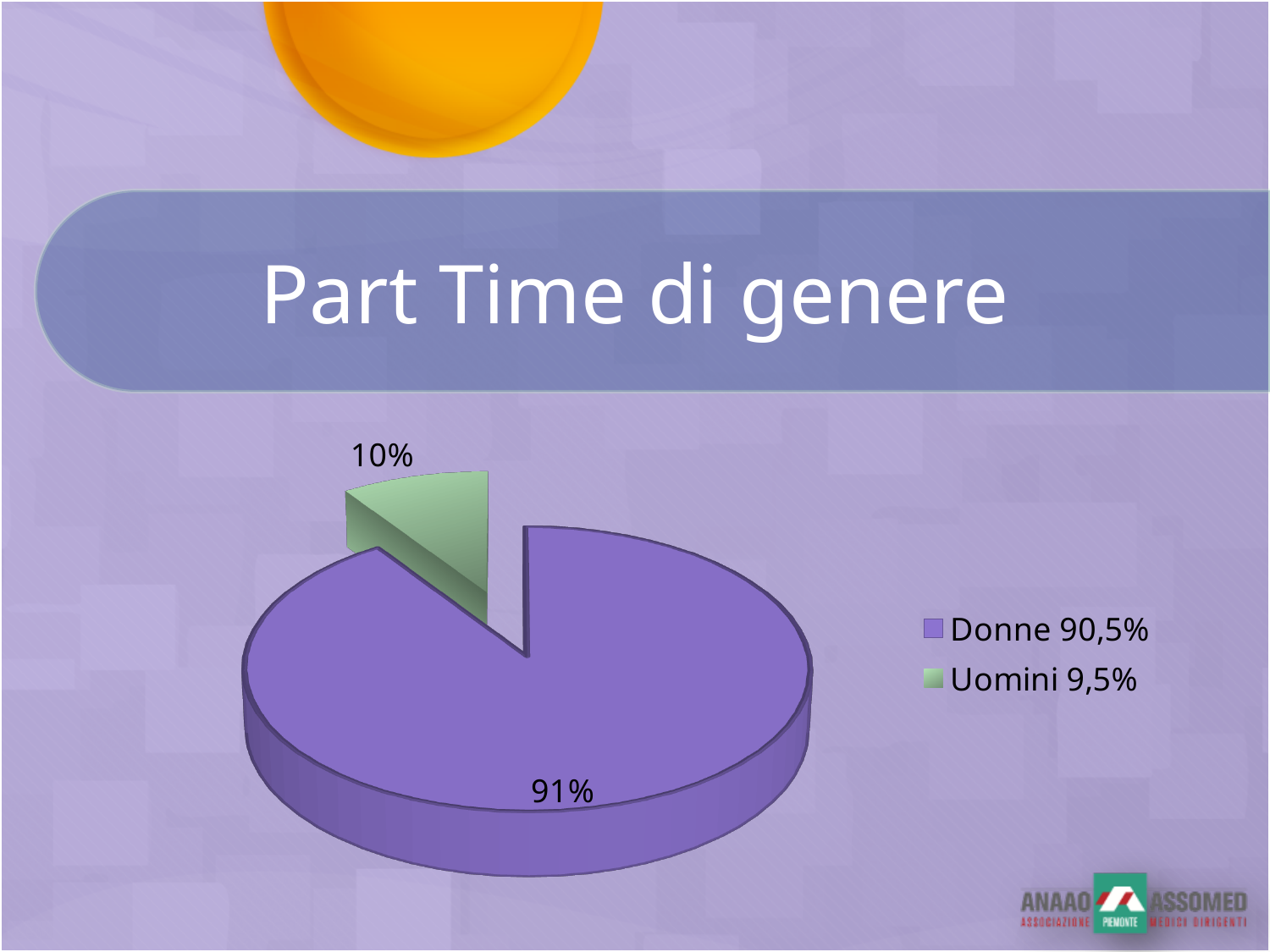
What colour is the Uomini slice in the pie chart? green How many entries does the legend list? 2 Which slice is the largest in the pie chart? Donne What percentage is printed as the data label on the Uomini slice? 10% How many slices does the pie chart have? 2 What percentage is printed as the data label on the Donne slice? 91% Which is larger, the Donne slice or the Uomini slice? Donne Which slice is the smallest in the pie chart? Uomini What kind of chart is shown on the slide? pie chart What is the difference between the data labels of the Donne slice and the Uomini slice? 81% What value does the legend give for Donne? 90,5% What is the title of the slide containing the chart? Part Time di genere